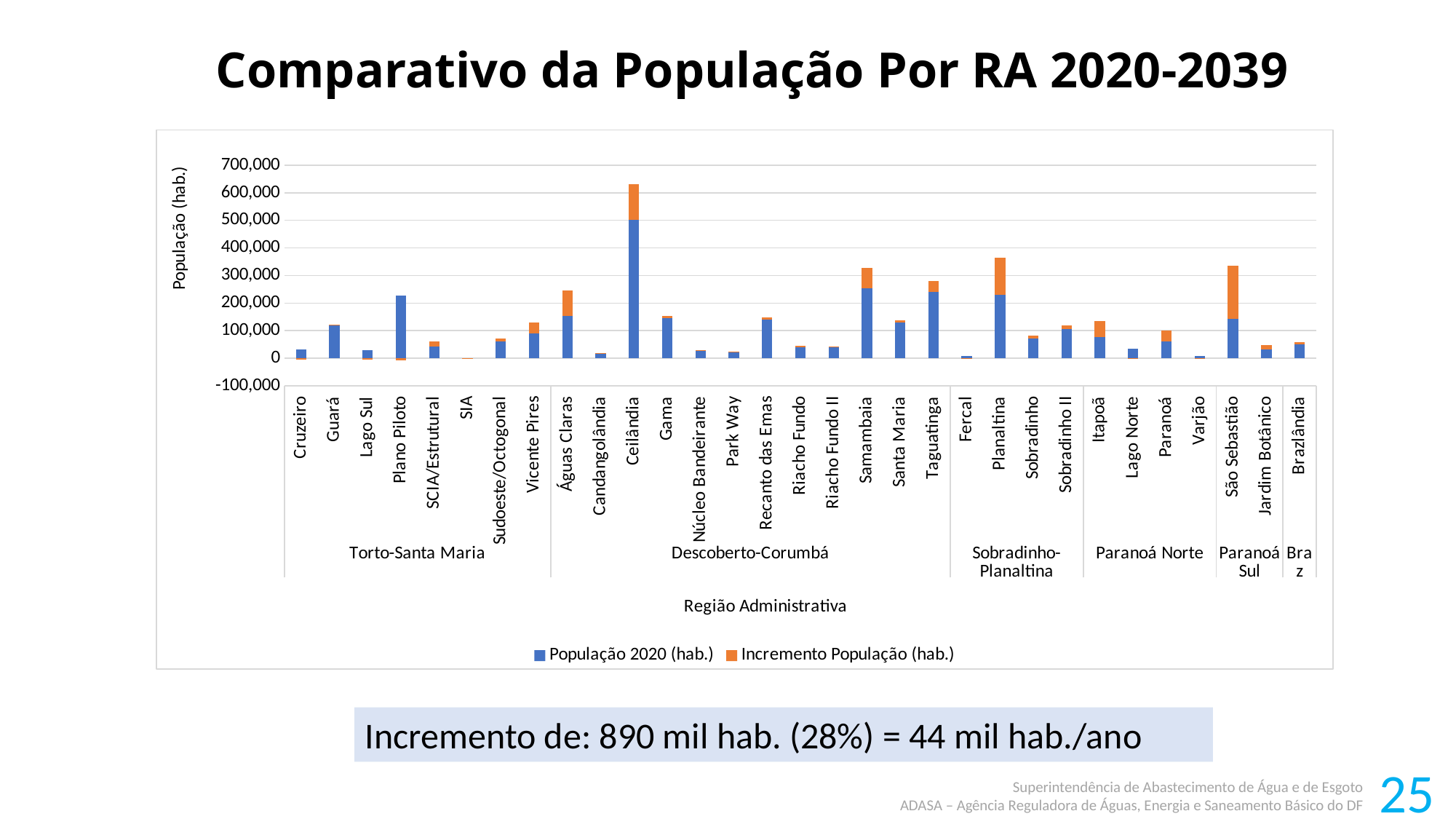
Which administrative region has the highest População 2020 (hab.)? Ceilândia What kind of chart is shown on the slide? Stacked bar chart What is the label of the y axis? População (hab.) What are the two series named in the legend? População 2020 (hab.) and Incremento População (hab.) Is the População 2020 (hab.) value for Ceilândia greater or less than 400,000? greater Which has the larger População 2020 (hab.), Ceilândia or Taguatinga? Ceilândia How many series does the legend list? 2 Is the População 2020 (hab.) value for Lago Sul greater or less than 100,000? less How many administrative regions (categories) are plotted on the x axis? 31 Which administrative region has the lowest População 2020 (hab.)? SIA Which has the larger Incremento População (hab.), São Sebastião or Guará? São Sebastião Is the População 2020 (hab.) value for Plano Piloto greater or less than 200,000? greater